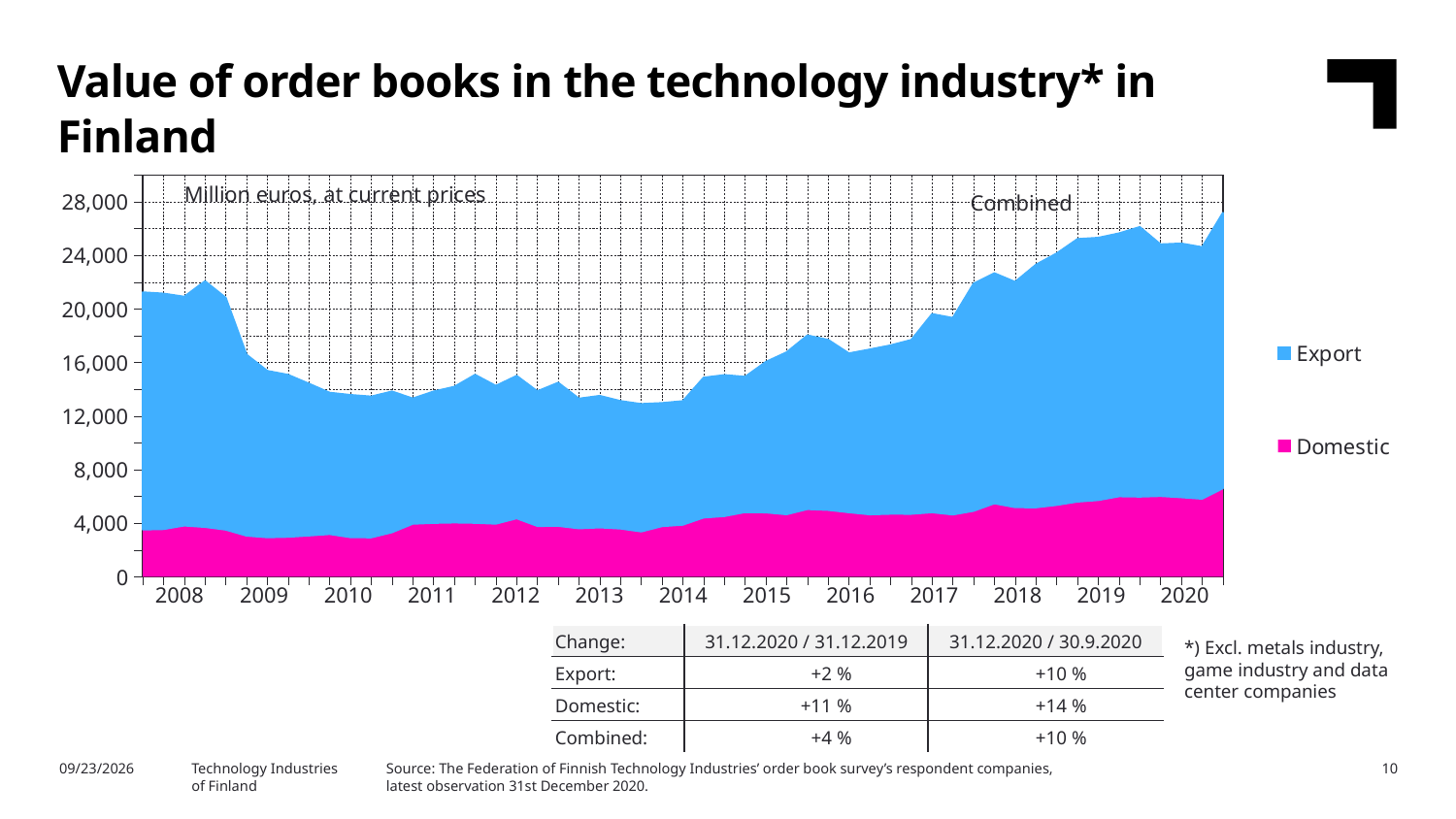
Which two series are listed in the chart's legend? Export and Domestic Is the combined value of order books in 2013 greater or less than 16,000? less In which year does the combined value of order books reach its highest point on the chart? 2020 How many years are labelled on the x axis of the chart? 13 Which is larger, the combined value of order books at the end of 2020 or in 2013? End of 2020 What unit label is printed inside the chart area? Million euros, at current prices What kind of chart is shown on the slide? Area chart Is the Domestic value in 2010 greater or less than 4,000? less Does the combined value of order books rise or fall from 2013 to 2020? rise Is the combined value of order books at the end of 2020 greater or less than 24,000? greater How many series does the chart's legend list? 2